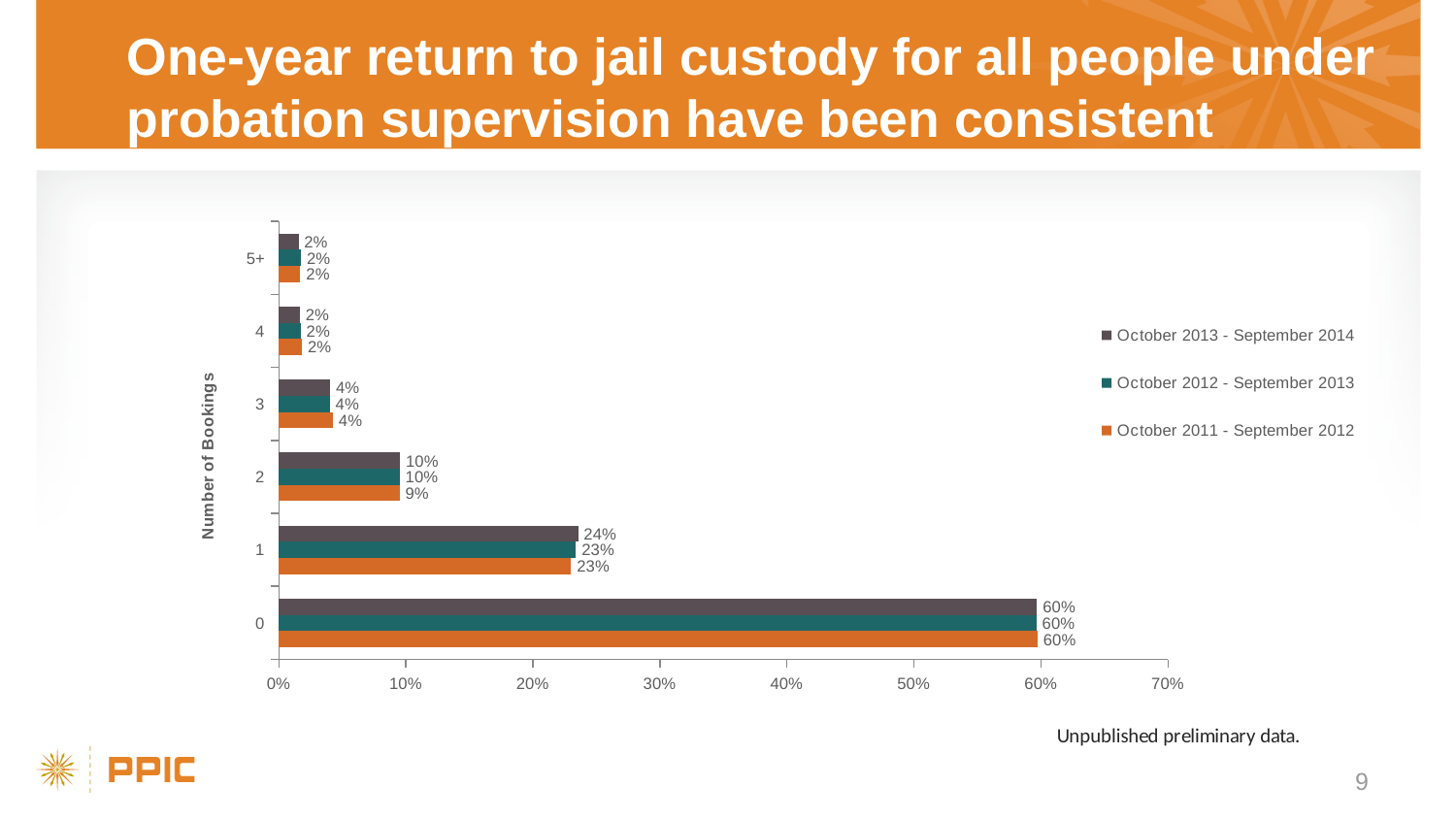
What is the value for 0 bookings in October 2013 - September 2014? 60% Which series is shown in orange in the legend? October 2011 - September 2012 What is the difference between the values for 1 booking and 2 bookings in October 2013 - September 2014? 14% How many series does the legend list? 3 How many number-of-bookings categories are shown on the y axis? 6 What kind of chart is shown on the slide? Bar chart What is the value for 3 bookings in October 2012 - September 2013? 4% What is the value for 1 booking in October 2013 - September 2014? 24% What is the label of the y axis? Number of Bookings What is the value for 2 bookings in October 2011 - September 2012? 9% Which is larger in October 2011 - September 2012: the value for 1 booking or the value for 2 bookings? 1 booking Which number of bookings category has the highest value in October 2012 - September 2013? 0